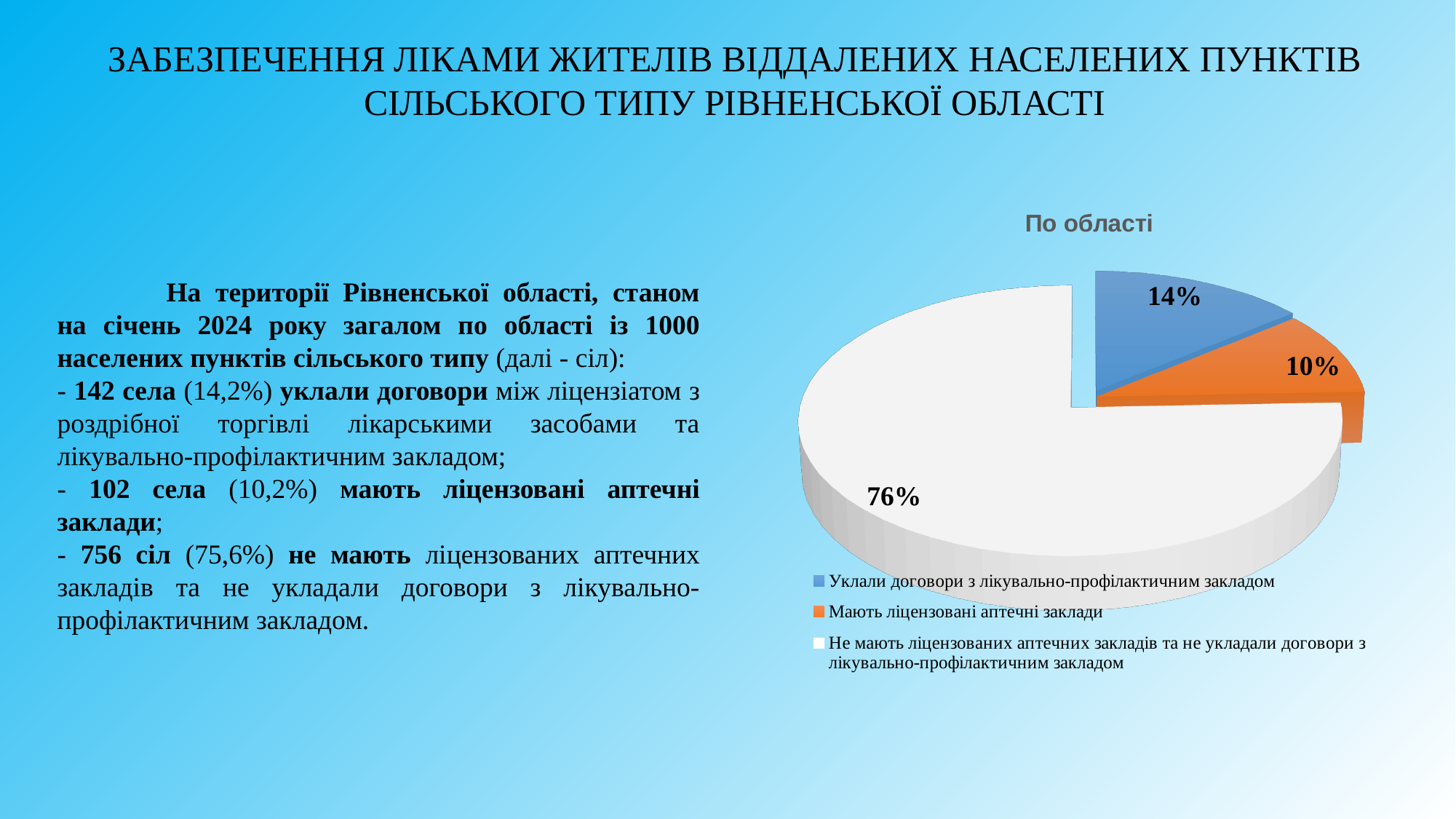
What kind of chart is shown on the slide? Pie chart What is the title of the chart? По області What share of the pie is labelled for 'Уклали договори з лікувально-профілактичним закладом'? 14% What colour is the slice for 'Мають ліцензовані аптечні заклади'? Orange Which category has the smallest slice of the pie? Мають ліцензовані аптечні заклади What share of the pie is labelled for 'Не мають ліцензованих аптечних закладів та не укладали договори з лікувально-профілактичним закладом'? 76% How many slices does the pie chart have? 3 Which slice is larger: 'Уклали договори з лікувально-профілактичним закладом' or 'Мають ліцензовані аптечні заклади'? Уклали договори з лікувально-профілактичним закладом Which category has the largest slice of the pie? Не мають ліцензованих аптечних закладів та не укладали договори з лікувально-профілактичним закладом How many entries does the chart legend list? 3 What share of the pie is labelled for 'Мають ліцензовані аптечні заклади'? 10% What is the difference in percentage points between the 76% slice and the 14% slice? 62